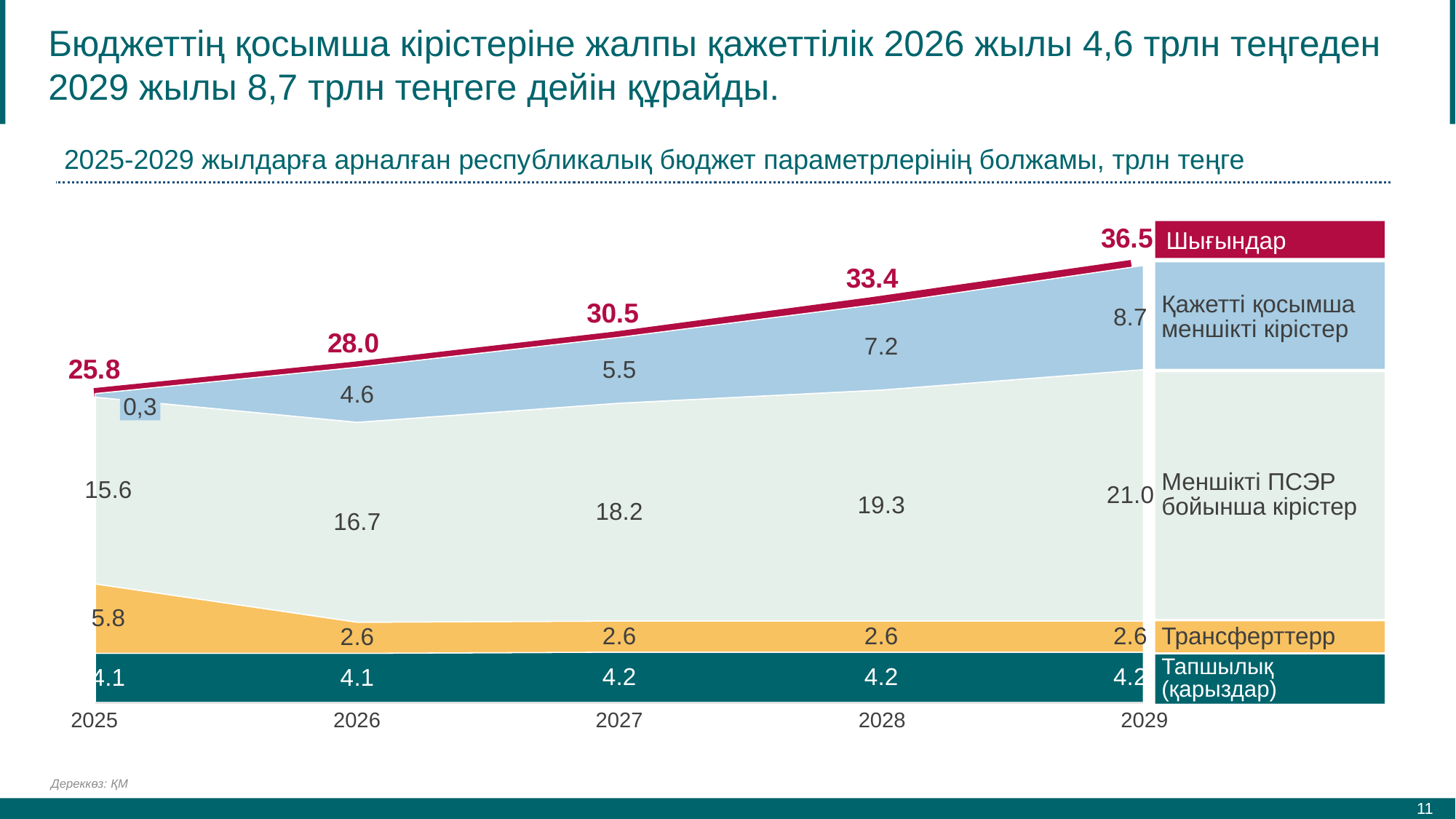
What is the value of Шығындар in 2029? 36.5 Does Шығындар rise or fall from 2025 to 2029? rise What is the value of Трансферттер in 2025? 5.8 What is the value of Меншікті ПСЭР бойынша кірістер in 2028? 19.3 Which is larger: Меншікті ПСЭР бойынша кірістер in 2027 or in 2026? 2027 In which year is Шығындар highest? 2029 What kind of chart is shown on the slide? area chart What is the value of Қажетті қосымша меншікті кірістер in 2027? 5.5 What is the difference between Шығындар in 2029 and in 2025? 10.7 How many years are shown on the x axis? 5 In which year is Қажетті қосымша меншікті кірістер lowest? 2025 What is the value of Тапшылық (қарыздар) in 2026? 4.1